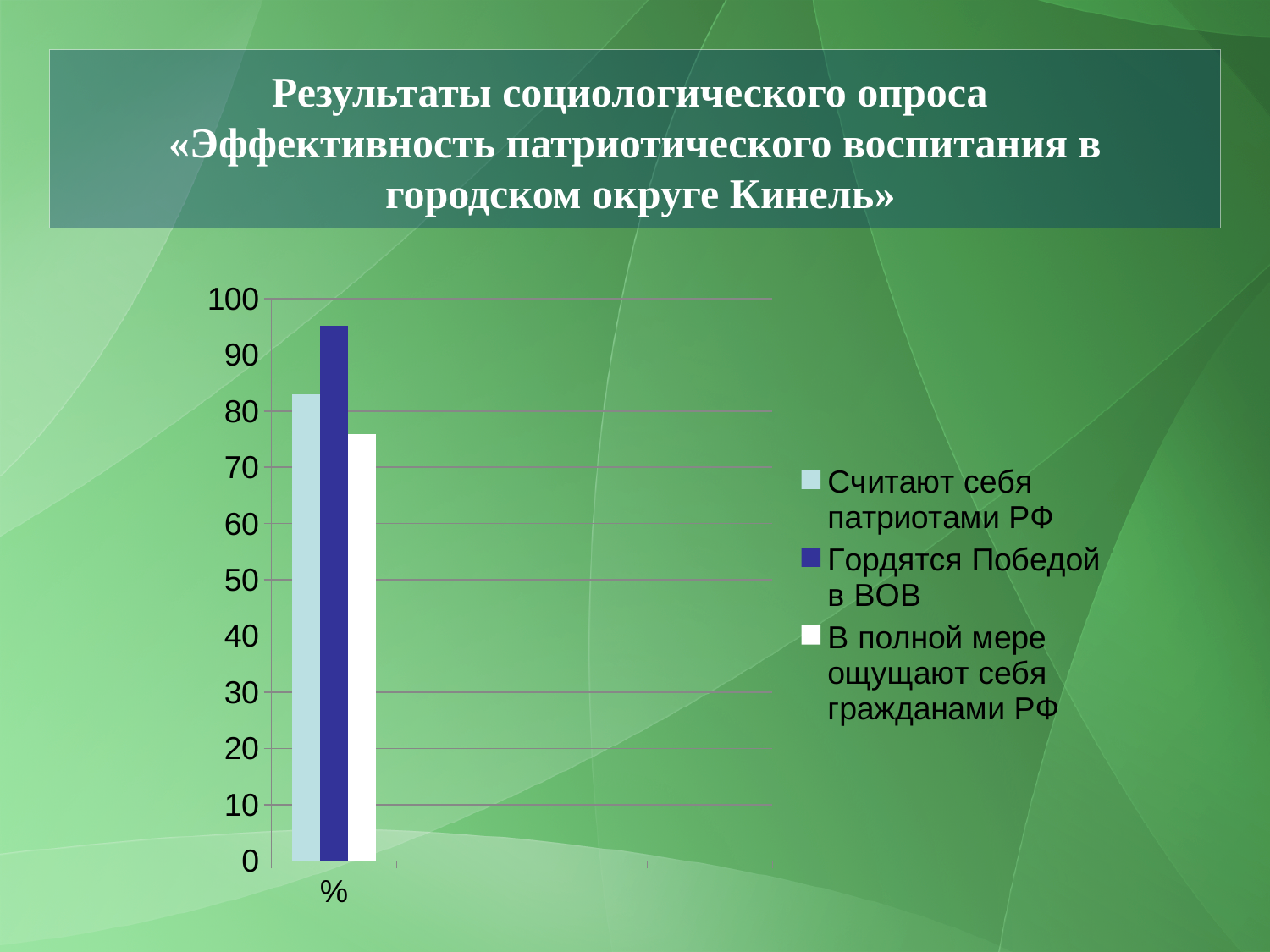
Which is larger: the value for "Считают себя патриотами РФ" or the value for "В полной мере ощущают себя гражданами РФ"? Считают себя патриотами РФ Is the value for "В полной мере ощущают себя гражданами РФ" greater or less than 70? greater What colour is the bar for "Гордятся Победой в ВОВ"? dark blue How many series does the legend list? 3 Which series has the highest bar? Гордятся Победой в ВОВ Is the value for "Считают себя патриотами РФ" greater or less than 80? greater Is the value for "Гордятся Победой в ВОВ" greater or less than 90? greater What kind of chart is shown on the slide? bar chart Which series has the lowest bar? В полной мере ощущают себя гражданами РФ What label is shown under the group of bars on the x axis? % How many categories are shown on the x axis? 1